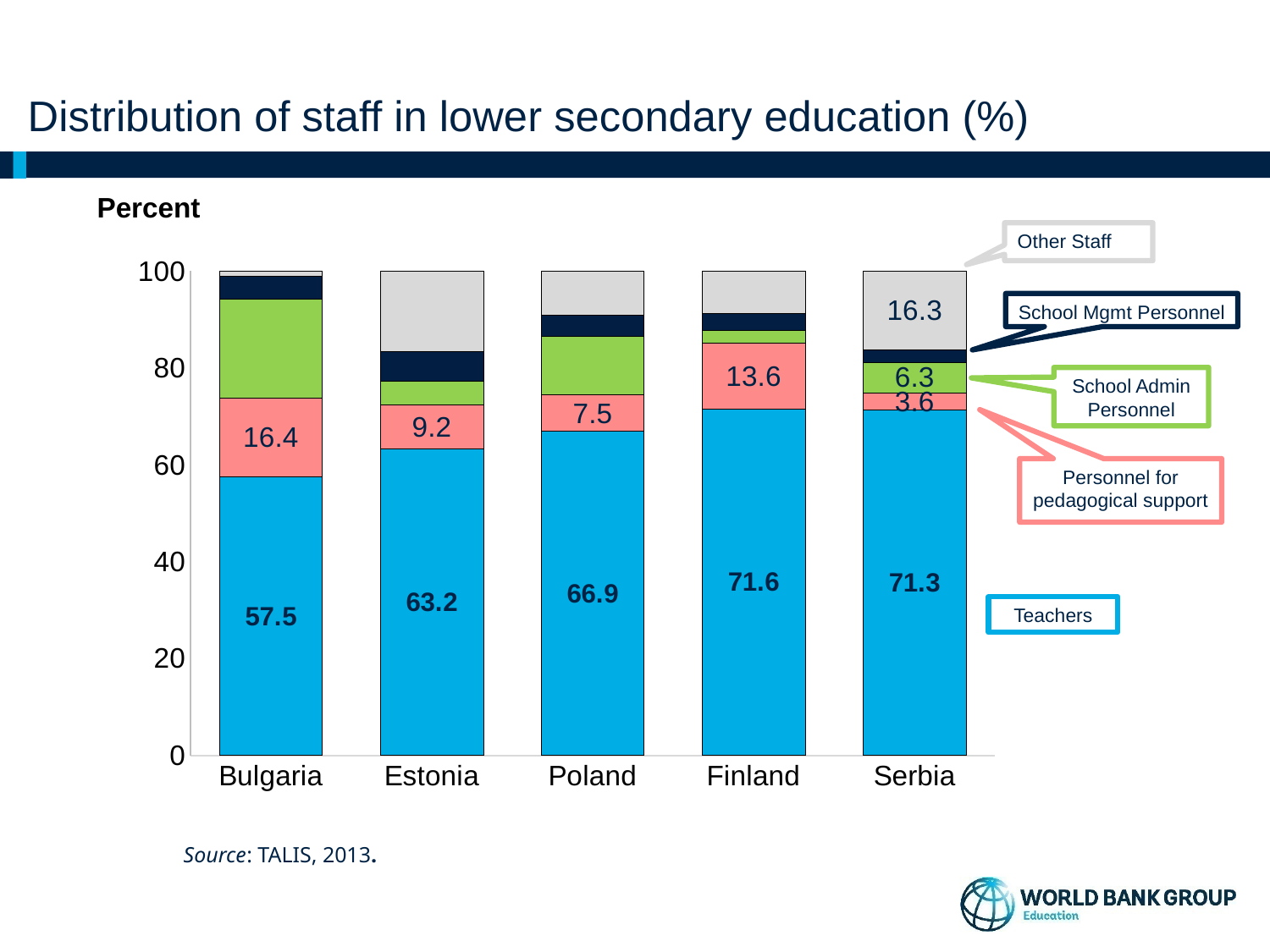
What is the Teachers value for Finland? 71.6 Which country has the highest Teachers share? Finland What is the difference between the Personnel for pedagogical support values for Poland and Serbia? 3.9 What kind of chart is shown on the slide? Stacked bar chart What is the difference between the Teachers values for Finland and Bulgaria? 14.1 How many countries are shown on the x axis? 5 Which has a larger Personnel for pedagogical support value, Bulgaria or Finland? Bulgaria Is the Other Staff value for Estonia greater or less than 20? less What is the Other Staff value for Serbia? 16.3 Which country has the lowest Teachers share? Bulgaria What is the value for Personnel for pedagogical support in Estonia? 9.2 What percentage of staff in Bulgaria are Teachers? 57.5